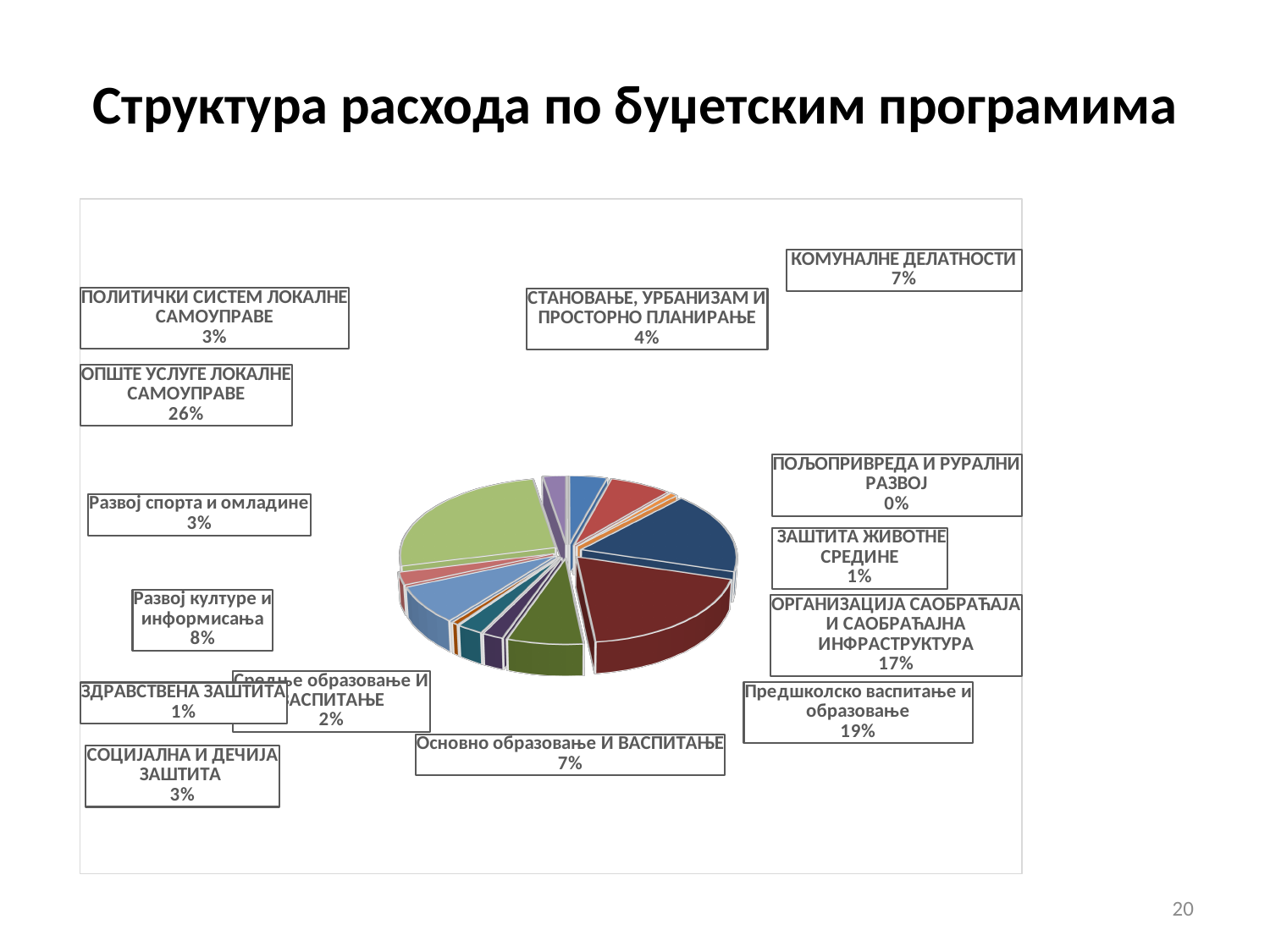
What percentage is shown for ОРГАНИЗАЦИЈА САОБРАЋАЈА И САОБРАЋАЈНА ИНФРАСТРУКТУРА? 17% What percentage is shown for Предшколско васпитање и образовање? 19% Which budget programme has the largest share of expenditure? ОПШТЕ УСЛУГЕ ЛОКАЛНЕ САМОУПРАВЕ What is the title of the slide? Структура расхода по буџетским програмима What share of expenditure goes to ОПШТЕ УСЛУГЕ ЛОКАЛНЕ САМОУПРАВЕ? 26% How many budget programmes are labelled on the pie chart? 14 What type of chart is shown on the slide? Pie chart Which budget programme has the smallest share of expenditure? ПОЉОПРИВРЕДА И РУРАЛНИ РАЗВОЈ What share is labelled for Развој културе и информисања? 8% What percentage is shown for СТАНОВАЊЕ, УРБАНИЗАМ И ПРОСТОРНО ПЛАНИРАЊЕ? 4% Which has a larger share: Предшколско васпитање и образовање or ОРГАНИЗАЦИЈА САОБРАЋАЈА И САОБРАЋАЈНА ИНФРАСТРУКТУРА? Предшколско васпитање и образовање How many percentage points larger is the share for ОПШТЕ УСЛУГЕ ЛОКАЛНЕ САМОУПРАВЕ than for Предшколско васпитање и образовање? 7 percentage points